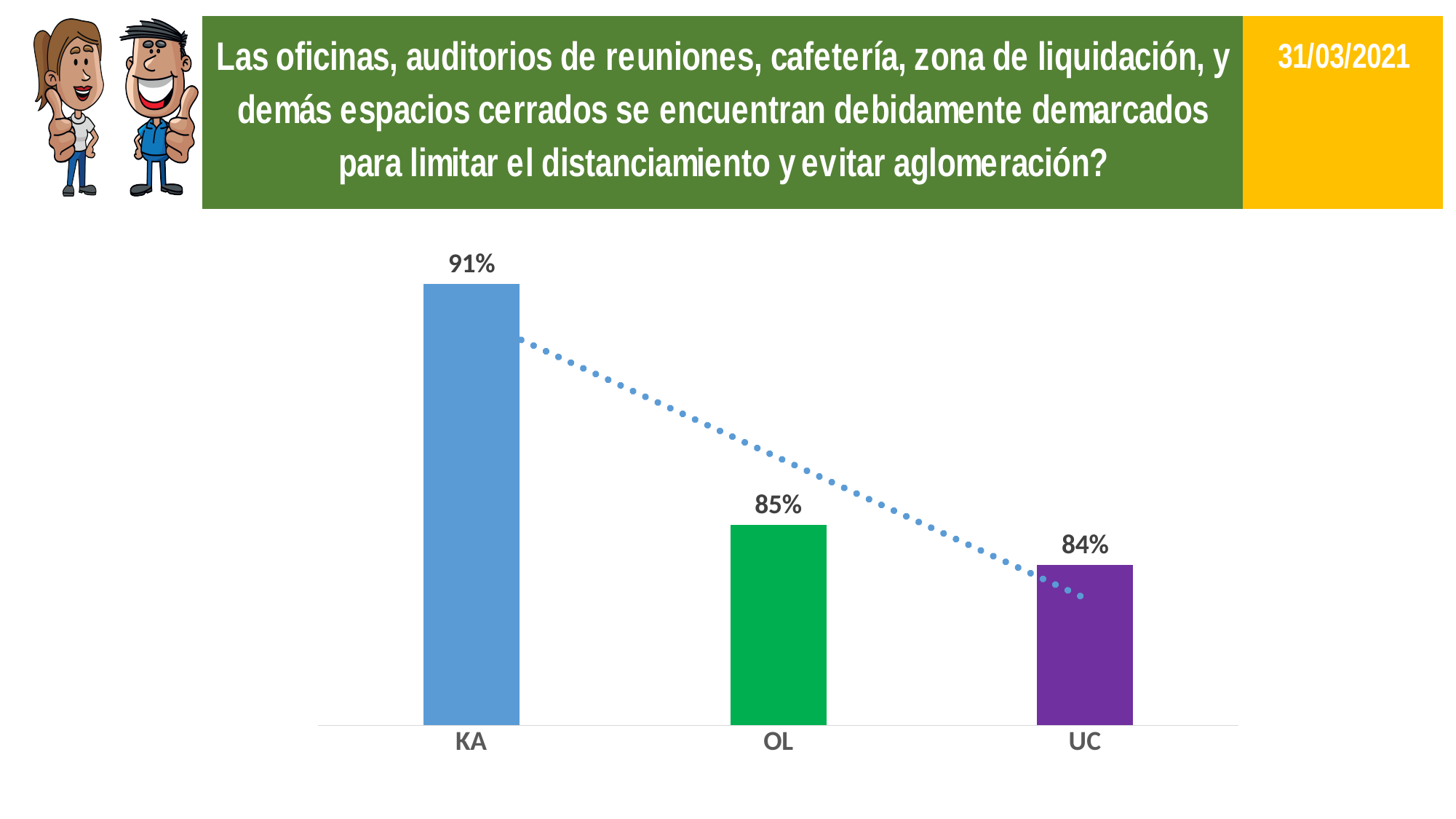
What colour is the bar for OL? Green What is the value for KA? 91% Which is larger, the value for KA or the value for OL? KA What is the difference between the values for KA and OL? 6% Which category has the lowest value? UC Do the values rise or fall from KA to UC along the x axis? Fall What is the value for OL? 85% How many categories are shown on the chart? 3 What is the difference between the values for KA and UC? 7% Which category has the highest value? KA What is the value for UC? 84% What kind of chart is shown on the slide? Bar chart